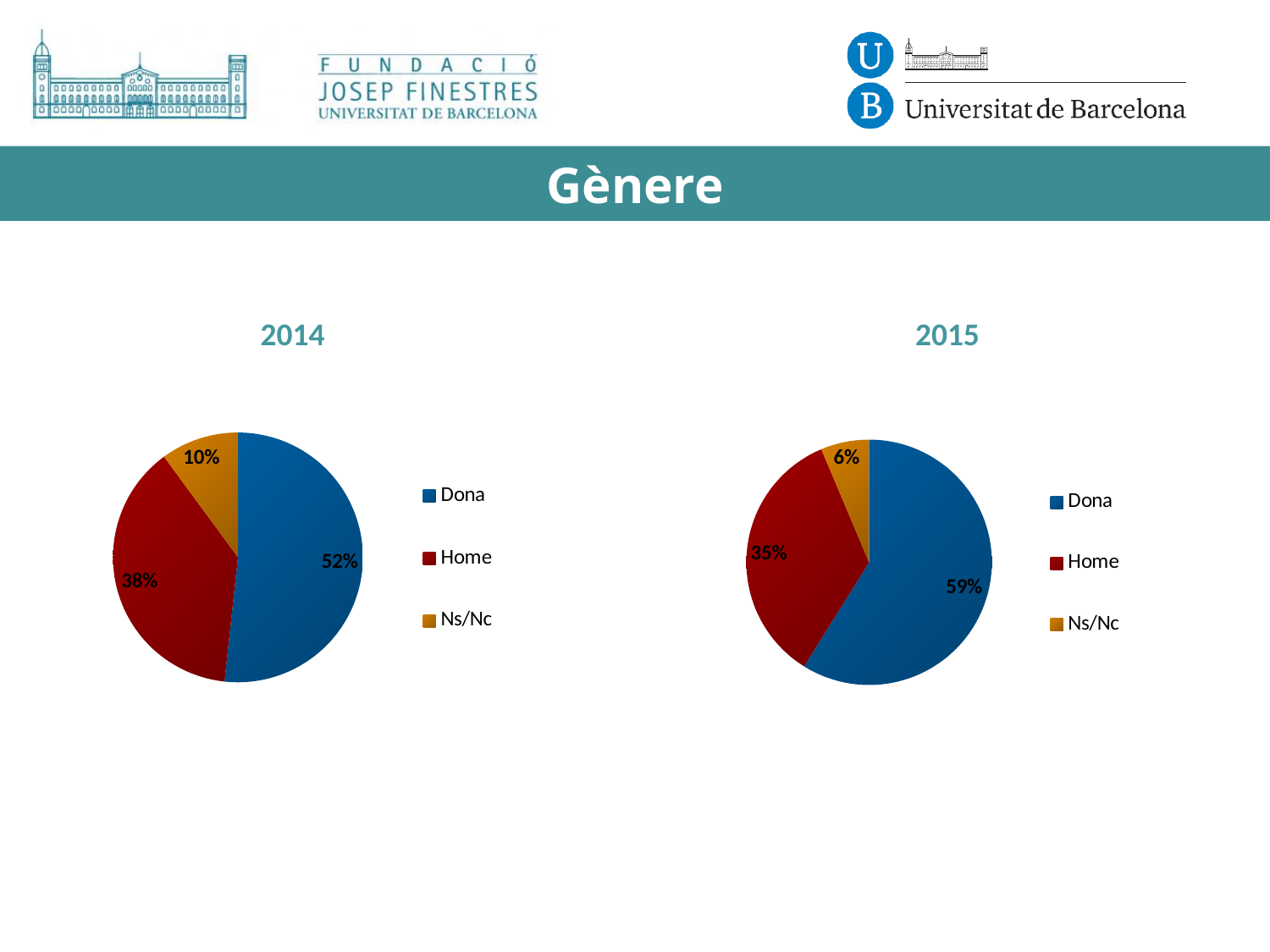
In the 2014 chart, what is the difference between the Dona and Home percentages? 14% Is the Dona share larger in the 2014 chart or the 2015 chart? 2015 How many categories does the 2014 chart show? 3 In the 2014 chart, what percentage is shown for Ns/Nc? 10% In the 2014 chart, which category has the smallest slice? Ns/Nc What kind of chart is the 2015 chart? Pie chart In the 2015 chart, what percentage is shown for Ns/Nc? 6% In the 2015 chart, what percentage is shown for Home? 35% In the 2015 chart, what is the difference between the Dona and Home percentages? 24% What colour represents Home in the 2014 chart's legend? Red In the 2015 chart, which category has the largest slice? Dona In the 2014 chart, what percentage is shown for Dona? 52%